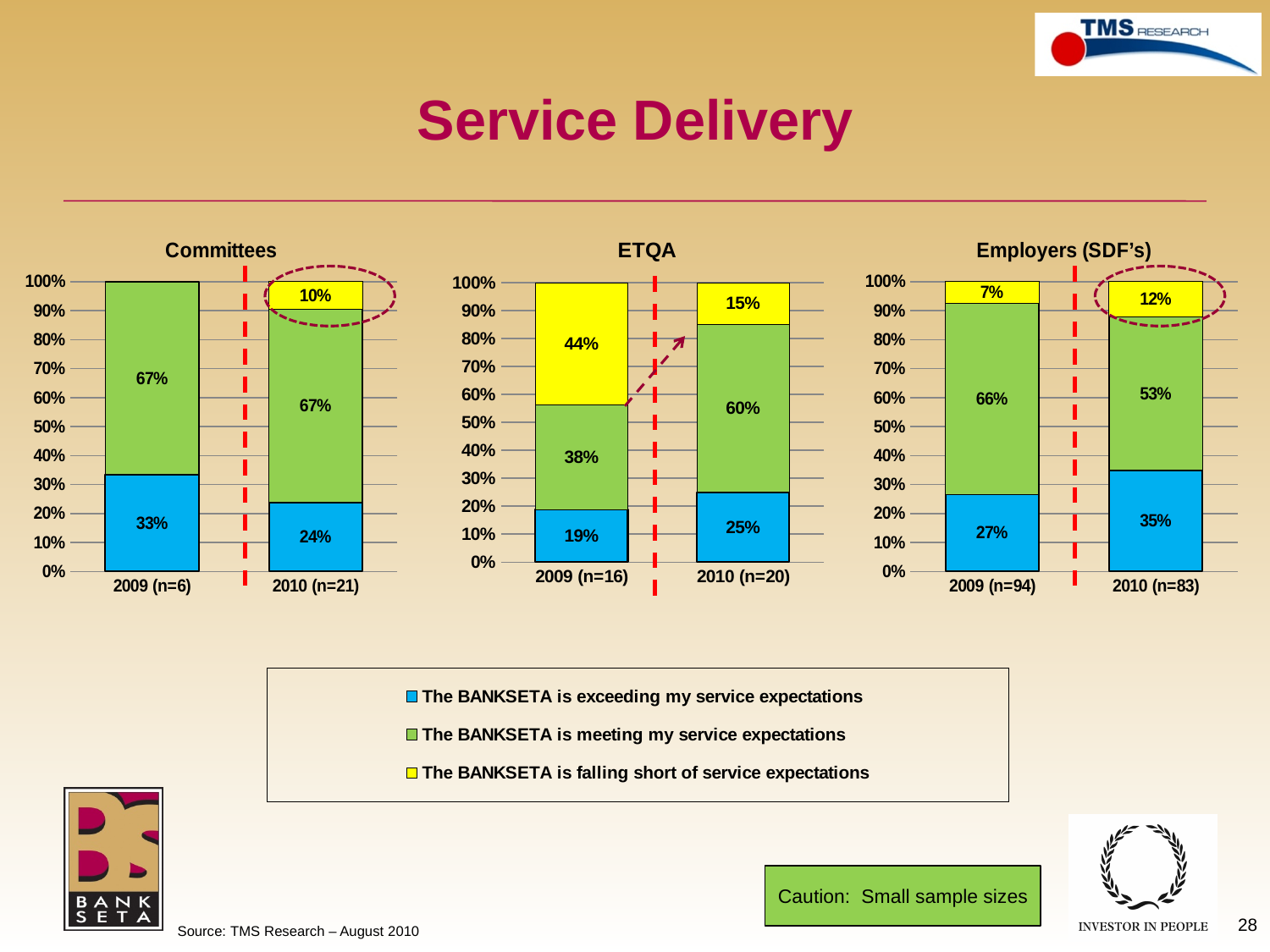
In the Committees chart, what percentage of respondents in 2010 (n=21) said the BANKSETA is exceeding their service expectations? 24% In the ETQA chart, what is the difference between the 'meeting my service expectations' share in 2010 (n=20) and in 2009 (n=16)? 22% In the Committees chart, what is the 'meeting my service expectations' share in 2009 (n=6)? 67% Which colour represents 'The BANKSETA is falling short of service expectations' in the legend? Yellow In the ETQA chart, what percentage of respondents in 2009 (n=16) said the BANKSETA is falling short of service expectations? 44% In the Employers (SDF's) chart, what is the difference between the 'exceeding my service expectations' share in 2010 (n=83) and in 2009 (n=94)? 8% In the Employers (SDF's) chart, what percentage of respondents in 2010 (n=83) said the BANKSETA is meeting their service expectations? 53% In the ETQA chart, which year has the larger 'falling short of service expectations' share, 2009 (n=16) or 2010 (n=20)? 2009 (n=16) In the Employers (SDF's) chart, what is the total of the 2009 (n=94) stacked bar? 100% What kind of chart is the Employers (SDF's) chart? Stacked bar chart In the Committees chart, how many bars are plotted? 2 How many series does the legend list? 3